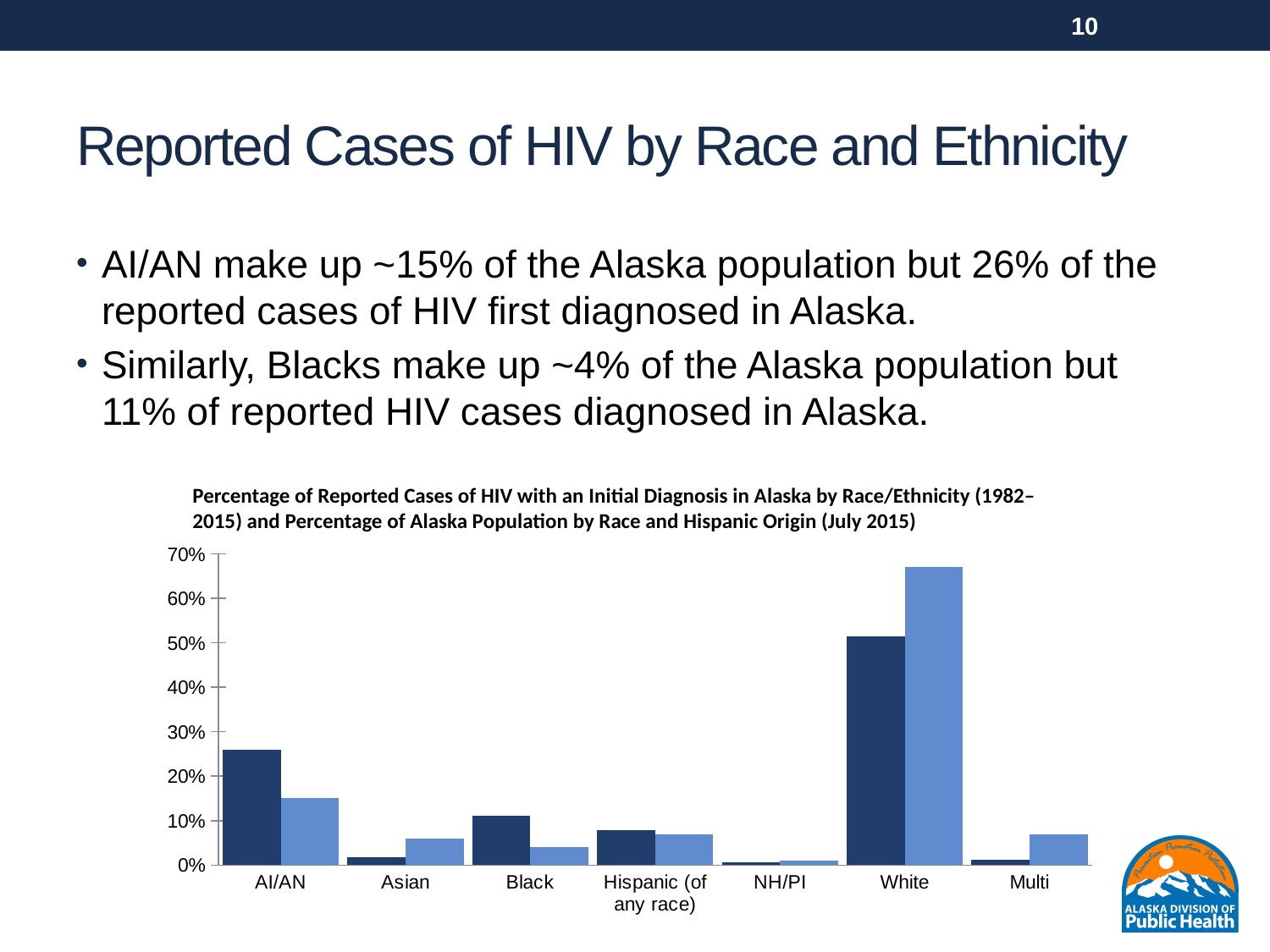
Is the light blue bar for White greater or less than 60%? greater What kind of chart is shown on the slide? bar chart Is the light blue bar for AI/AN greater or less than 10%? greater Which category has the lowest light blue bar in the chart? NH/PI Is the dark blue bar for AI/AN greater or less than 20%? greater What is the highest value shown on the chart's y axis? 70% For AI/AN, which bar is taller, the dark blue bar or the light blue bar? dark blue For White, which bar is taller, the dark blue bar or the light blue bar? light blue Which category has the tallest bars in the chart? White How many race/ethnicity categories are shown on the x axis of the chart? 7